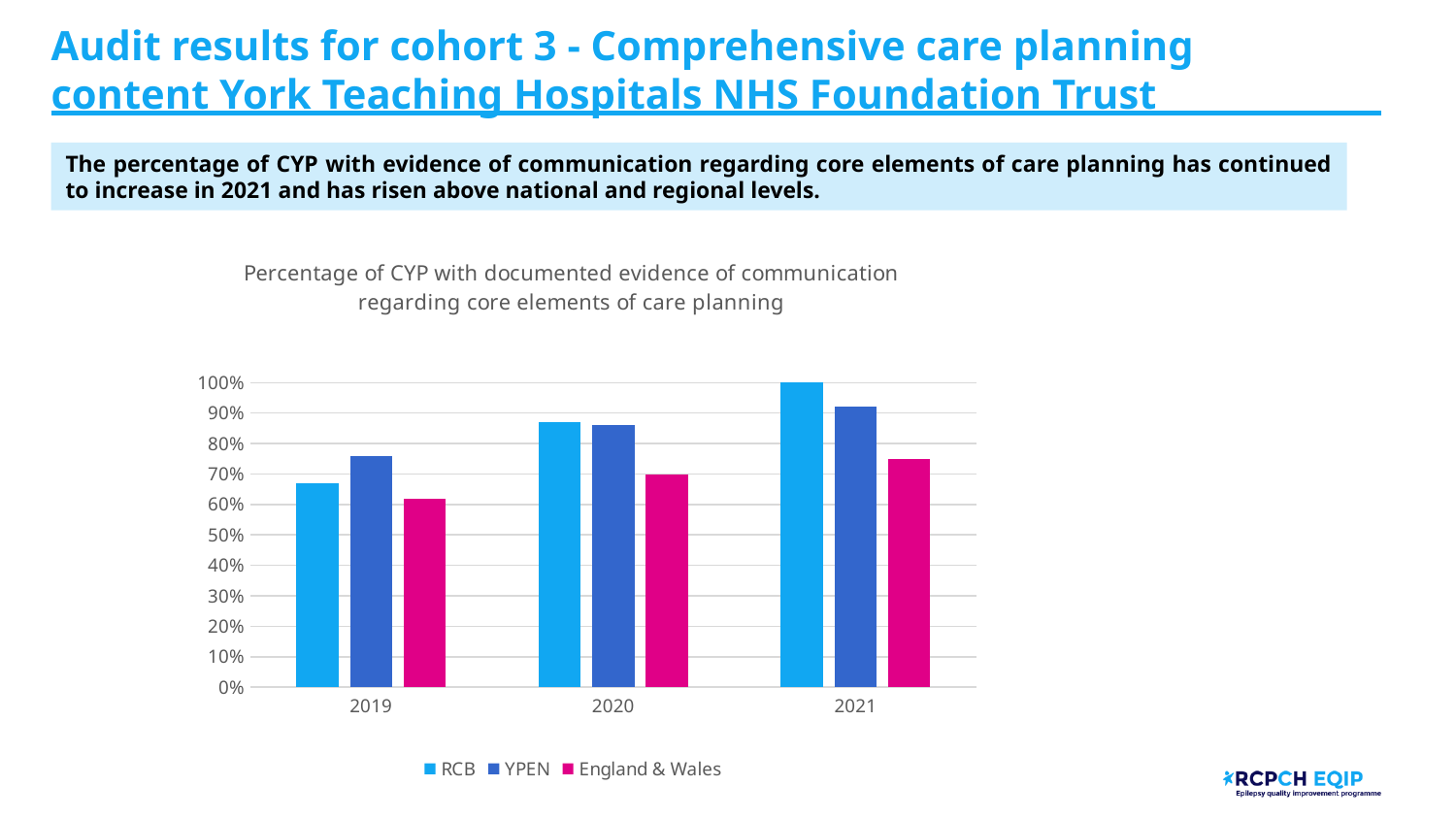
In 2019, which is larger: the value for RCB or the value for YPEN? YPEN Which series has the highest value in 2021? RCB Which series has the lowest value in 2019? England & Wales How many series does the legend list? 3 What is the value for RCB in 2021? 100% How many years are shown on the x axis? 3 Is the value for RCB in 2020 greater or less than 80%? greater What is the title of the chart? Percentage of CYP with documented evidence of communication regarding core elements of care planning Do the RCB values rise or fall from 2019 to 2021? rise What type of chart is shown on the slide? bar chart Is the value for England & Wales in 2019 greater or less than 70%? less Is the value for YPEN in 2021 greater or less than 90%? greater